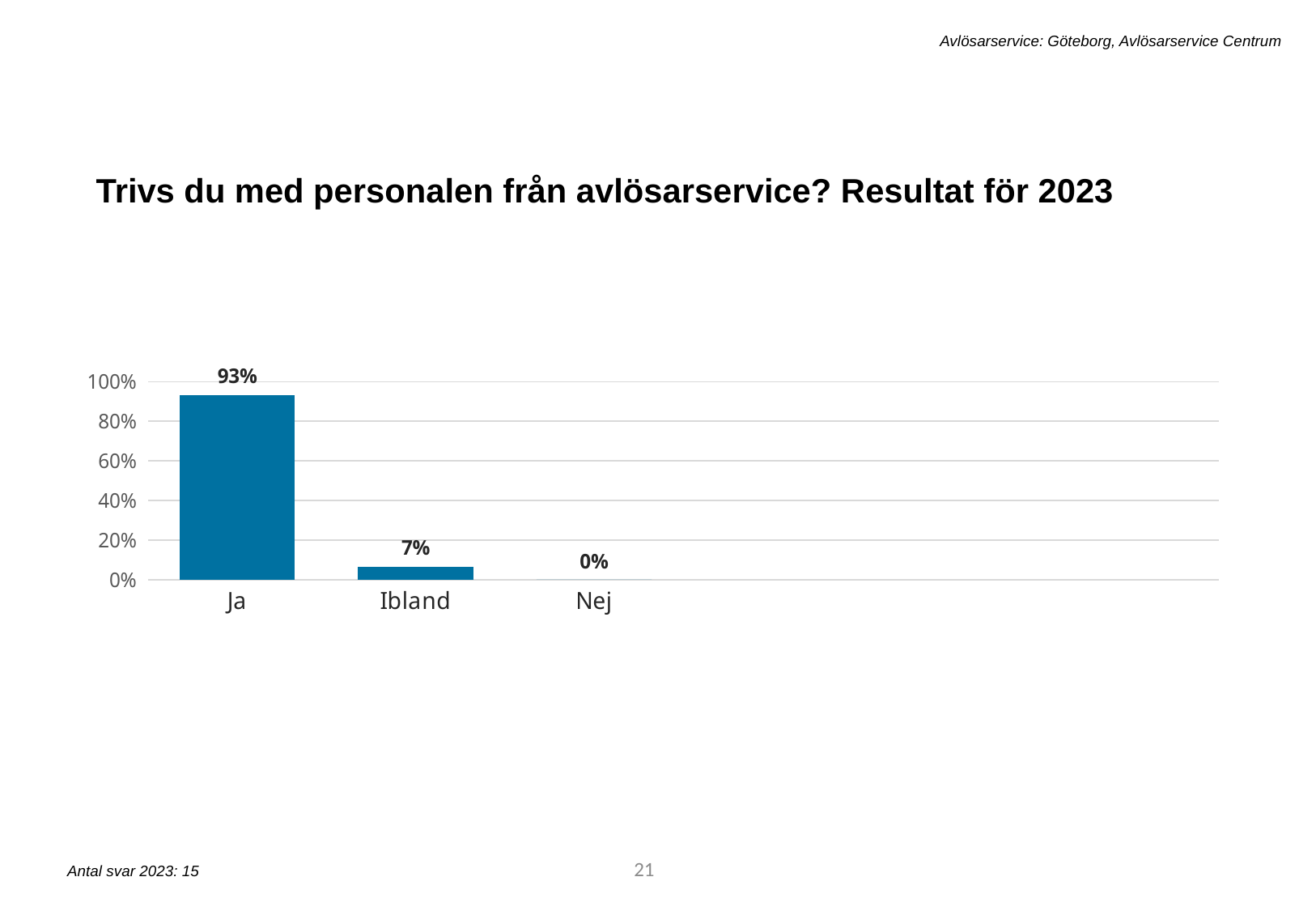
What is the title of the chart? Trivs du med personalen från avlösarservice? Resultat för 2023 Is the value for Ja greater or less than 80%? greater Which category has the highest value? Ja What kind of chart is shown on the slide? bar chart What is the value for Nej? 0% Which is larger, the value for Ibland or the value for Nej? Ibland How many categories are shown on the x axis? 3 What is the difference between the values for Ja and Ibland? 86% Which category has the lowest value? Nej Is the value for Ibland greater or less than 20%? less What is the value for Ibland? 7% What is the value for Ja? 93%